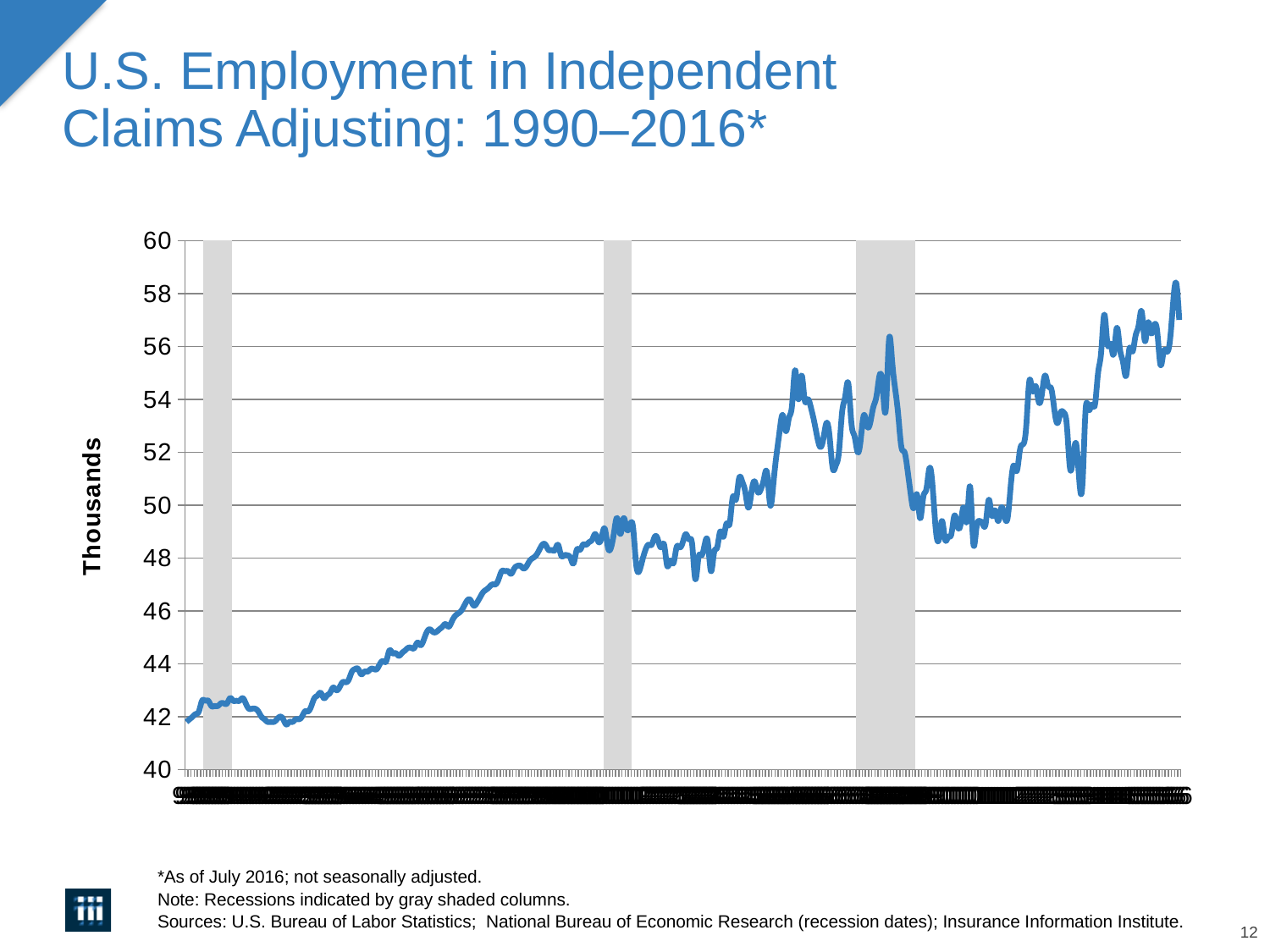
What is the label on the vertical axis of the chart? Thousands What is the highest value shown on the vertical axis? 60 What is the title of the chart on the slide? U.S. Employment in Independent Claims Adjusting: 1990–2016* Overall, do the values rise or fall from the start of the series to the end? rise What kind of chart is shown on the slide? line chart Is the highest point on the line greater or less than 58? greater Is the value at the start of the series greater or less than 44? less Is the value at the end of the series greater or less than 56? greater